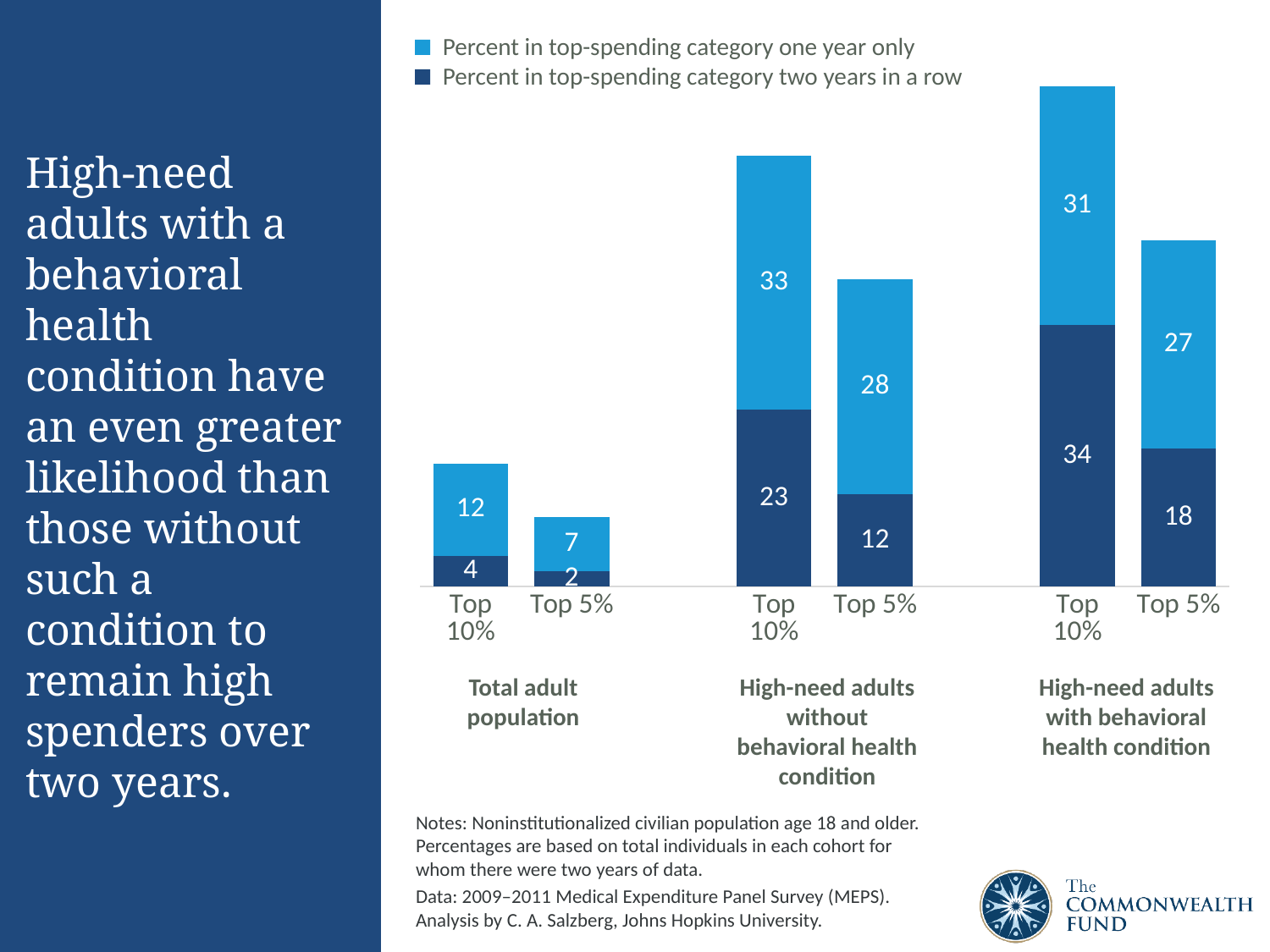
How many series does the legend list? 2 For the Top 10% bar among high-need adults with a behavioral health condition, which is larger: the one-year-only value or the two-years-in-a-row value? Two years in a row What kind of chart is shown on the slide? Stacked bar chart Which bar has the highest value for percent in top-spending category two years in a row? Top 10%, high-need adults with behavioral health condition What is the difference between the two-years-in-a-row values for the Top 5% bars of high-need adults with and without a behavioral health condition? 6 What is the percent in the top-spending category two years in a row for the Top 10% bar among high-need adults without a behavioral health condition? 23 What is the percent in the top-spending category two years in a row for the Top 10% bar among high-need adults with a behavioral health condition? 34 How many bars are plotted in the chart? 6 Which bar has the lowest value for percent in top-spending category two years in a row? Top 5%, total adult population What is the total height of the Top 5% bar for high-need adults without a behavioral health condition? 40 What is the total height of the Top 10% bar for high-need adults with a behavioral health condition? 65 What is the percent in the top-spending category one year only for the Top 5% bar in the total adult population? 7